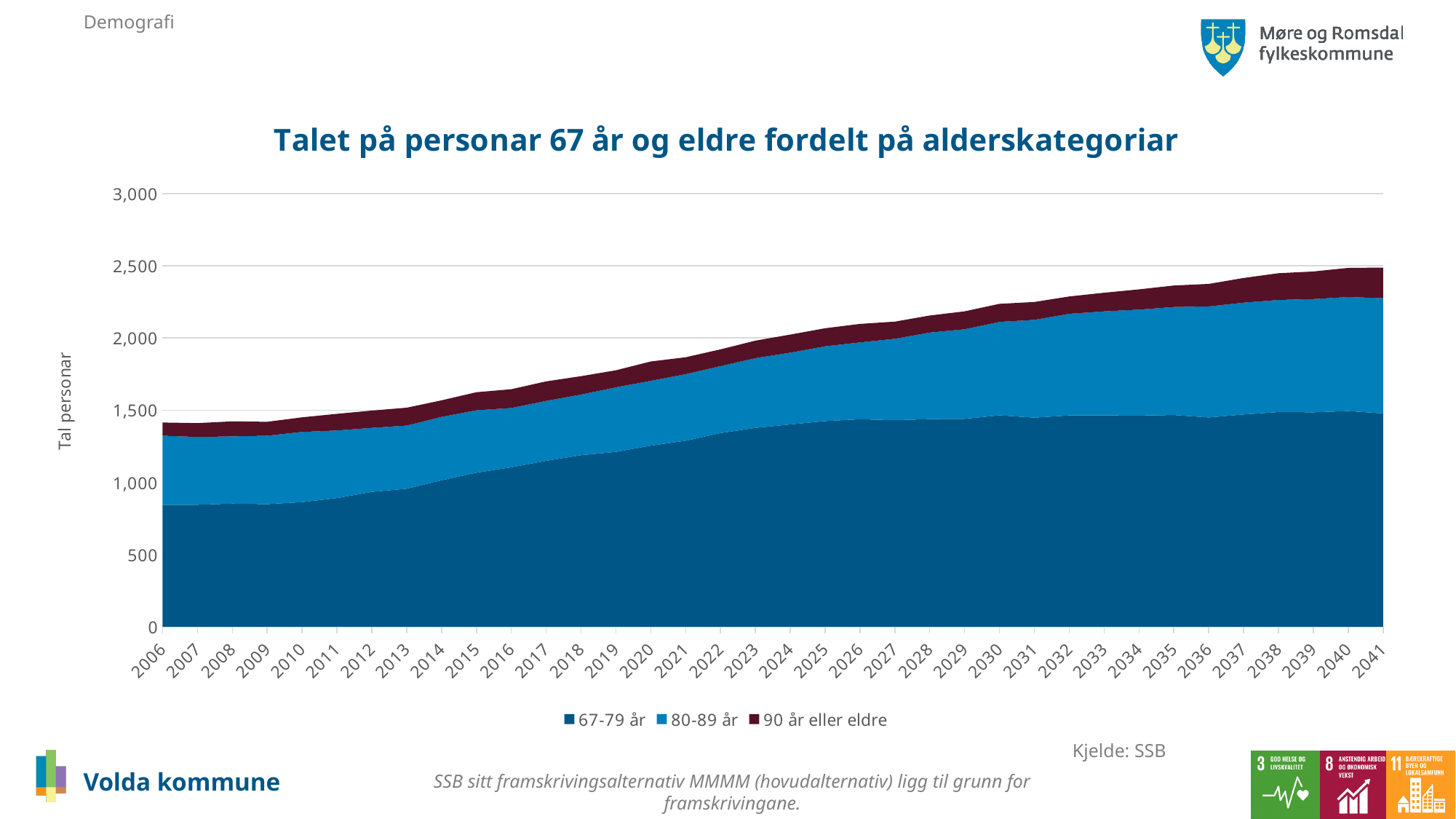
How many years are shown along the x axis? 36 Which age category has the largest number of persons throughout the period? 67-79 år Is the total number of persons 67 years and older in 2020 greater or less than 2,000? less Does the total number of persons 67 years and older rise or fall from 2006 to 2041? Rise In 2041, which is larger: the value for 67-79 år or the value for 80-89 år? 67-79 år Is the total number of persons 67 years and older in 2041 greater or less than 2,000? greater Which age category has the smallest number of persons throughout the period? 90 år eller eldre How many series does the legend list? 3 What is the first year shown on the x axis? 2006 Is the value for 67-79 år in 2006 greater or less than 1,000? less What is the title of the chart? Talet på personar 67 år og eldre fordelt på alderskategoriar What kind of chart is shown on the slide? Stacked area chart